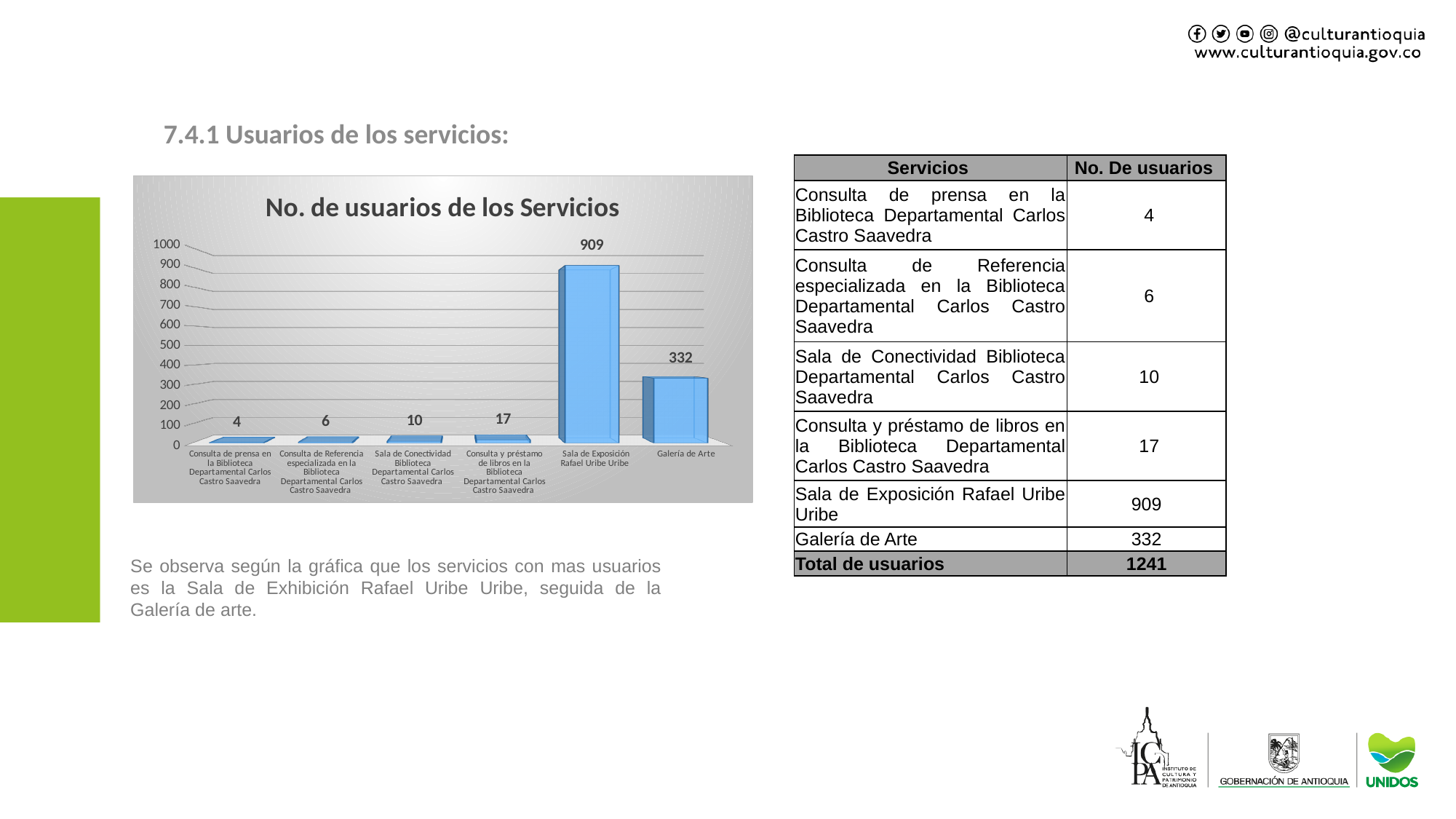
What is the value for Sala de Exposición Rafael Uribe Uribe? 909 How many categories are plotted in the chart? 6 What kind of chart is shown on the slide? bar chart What is the value for Galería de Arte? 332 Which category has the lowest value? Consulta de prensa en la Biblioteca Departamental Carlos Castro Saavedra What is the difference between the values for Sala de Exposición Rafael Uribe Uribe and Galería de Arte? 577 What is the title of the chart? No. de usuarios de los Servicios What is the value for Consulta y préstamo de libros en la Biblioteca Departamental Carlos Castro Saavedra? 17 Which is larger, the value for Consulta de Referencia especializada en la Biblioteca Departamental Carlos Castro Saavedra or the value for Sala de Conectividad Biblioteca Departamental Carlos Castro Saavedra? Sala de Conectividad Biblioteca Departamental Carlos Castro Saavedra What is the value for Sala de Conectividad Biblioteca Departamental Carlos Castro Saavedra? 10 Which category has the highest value? Sala de Exposición Rafael Uribe Uribe Is the value for Galería de Arte greater or less than 500? less